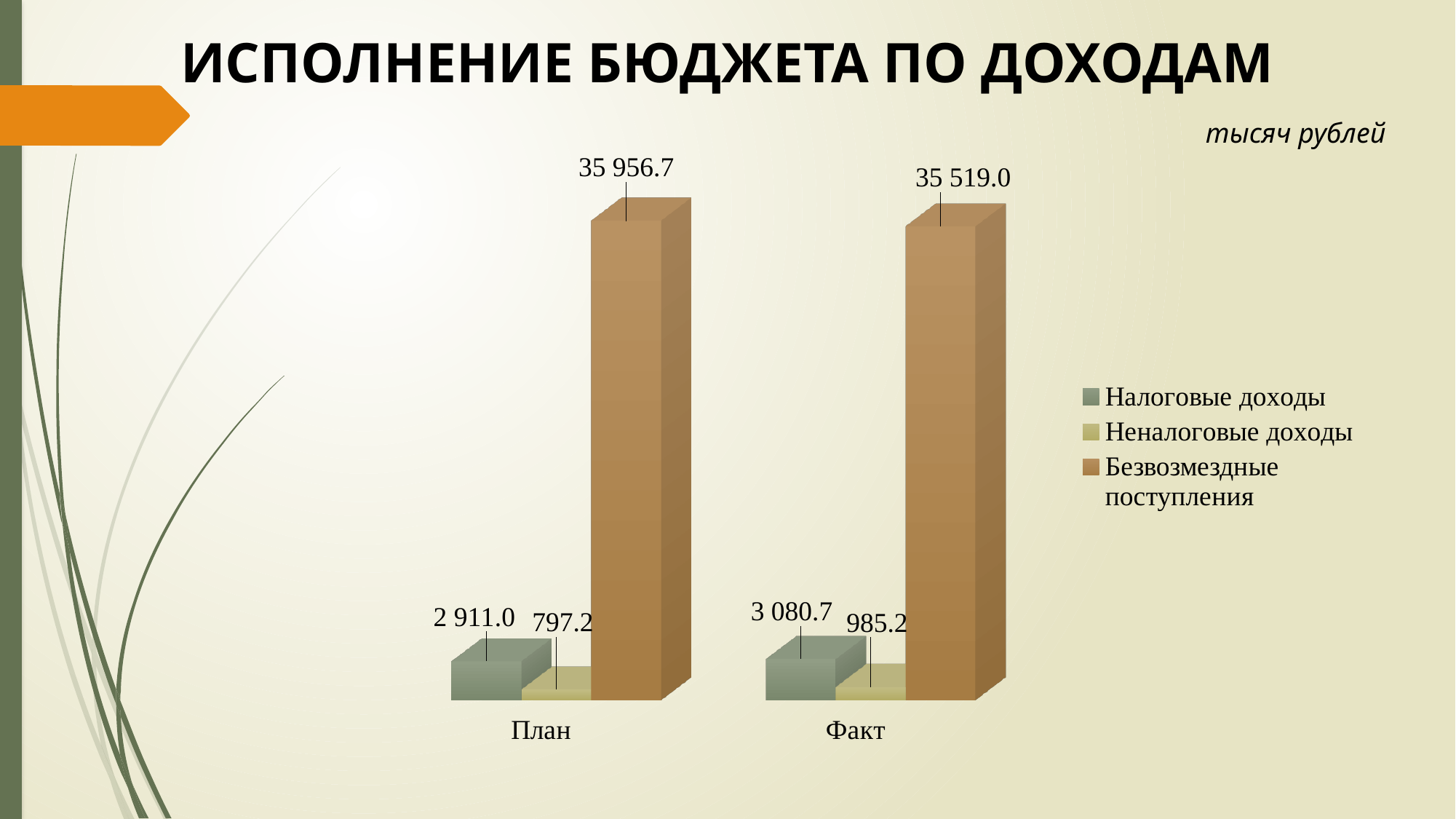
How many series does the legend list? 3 What is the value of Безвозмездные поступления for Факт? 35 519.0 What is the difference between Безвозмездные поступления for План and for Факт? 437.7 What is the value of Безвозмездные поступления for План? 35 956.7 What is the value of Налоговые доходы for План? 2 911.0 How many categories are shown on the x axis? 2 What kind of chart is shown on the slide? Bar chart Which is larger: Неналоговые доходы for План or for Факт? Факт What is the value of Неналоговые доходы for Факт? 985.2 Which series has the lowest value for План? Неналоговые доходы What is the difference between Налоговые доходы for Факт and for План? 169.7 Which series has the highest value for Факт? Безвозмездные поступления